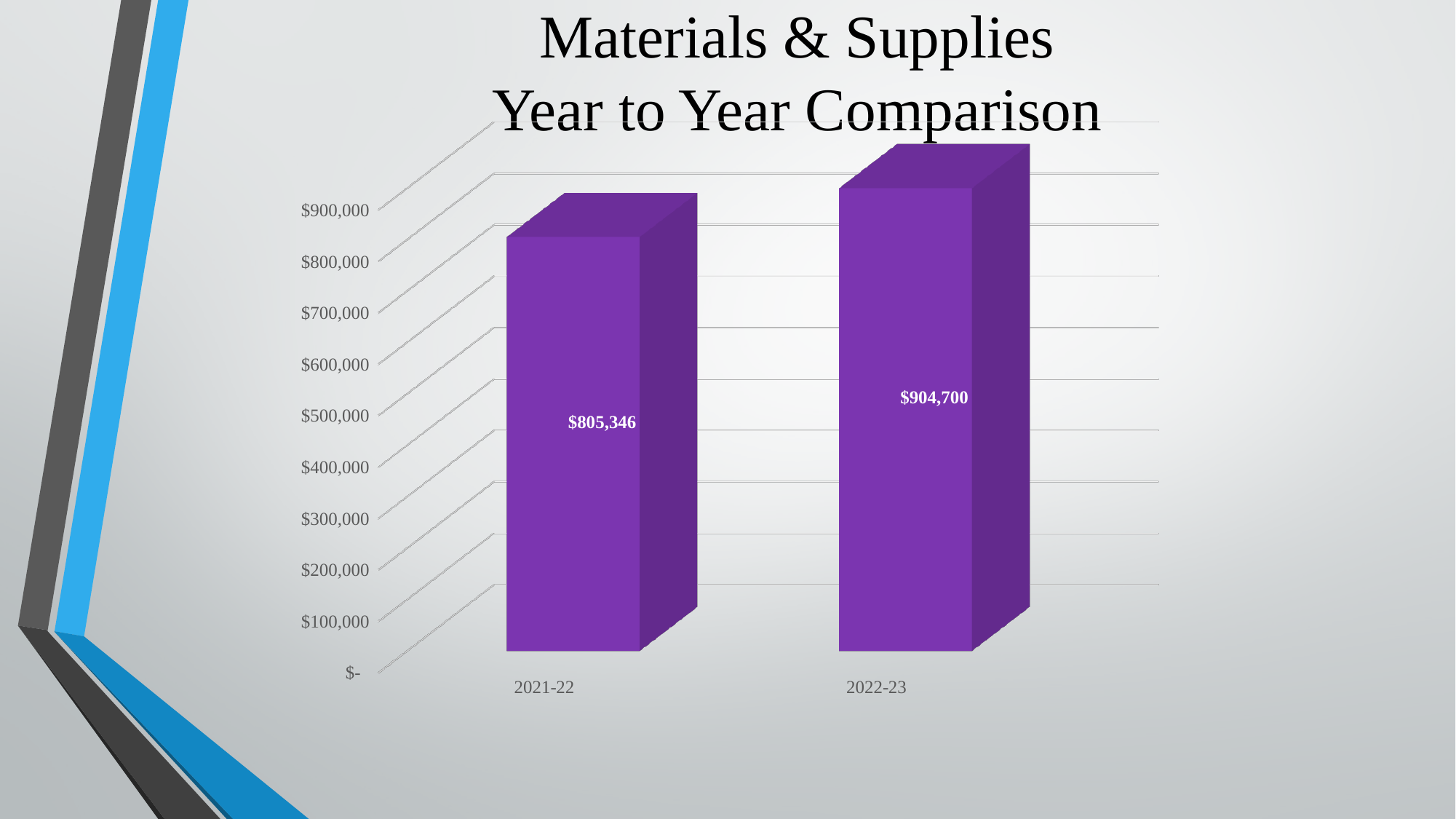
What is the value for 2022-23? $904,700 Is the value for 2021-22 greater or less than $900,000? less Is the value for 2022-23 greater or less than $900,000? greater What is the value for 2021-22? $805,346 What is the difference between the 2022-23 and 2021-22 values? $99,354 How many categories are shown on the x axis? 2 Do the values rise or fall from 2021-22 to 2022-23? Rise Which year has the higher value? 2022-23 What is the title of the chart? Materials & Supplies Year to Year Comparison Is the value for 2022-23 larger than the value for 2021-22? Yes Which year has the lower value? 2021-22 What kind of chart is shown on the slide? Bar chart